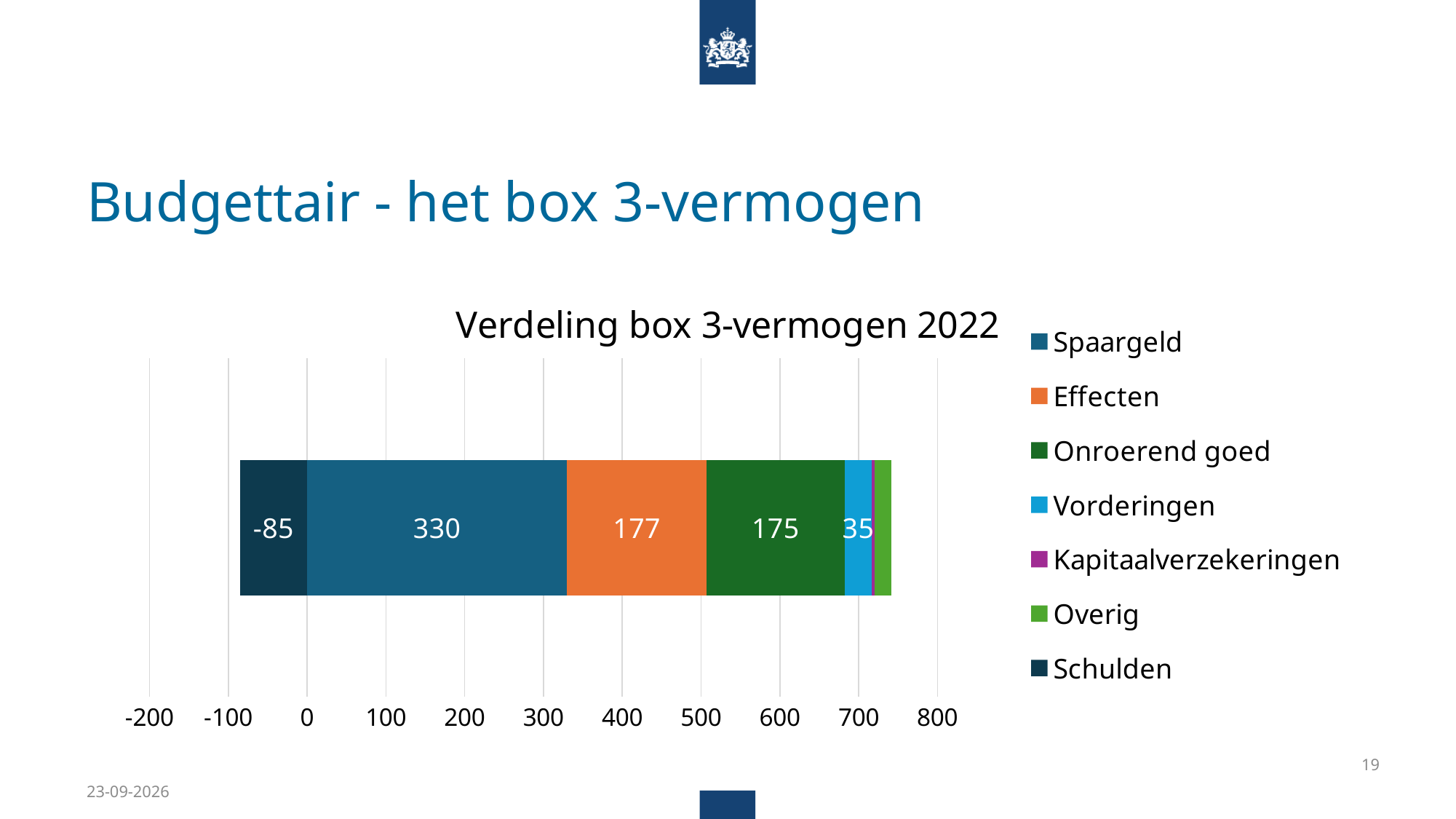
What is the value for Onroerend goed? 175 Is the value for Overig greater or less than 100? less Which series has the lowest value in the chart? Schulden What kind of chart is shown on the slide? Stacked bar chart What is the value for Schulden? -85 What is the value for Effecten? 177 What is the value for Spaargeld in the Verdeling box 3-vermogen 2022 chart? 330 Which is larger, the value for Spaargeld or the value for Onroerend goed? Spaargeld What is the value for Vorderingen? 35 How many series does the legend list? 7 What is the difference between the values for Spaargeld and Effecten? 153 Which series has the highest value in the chart? Spaargeld